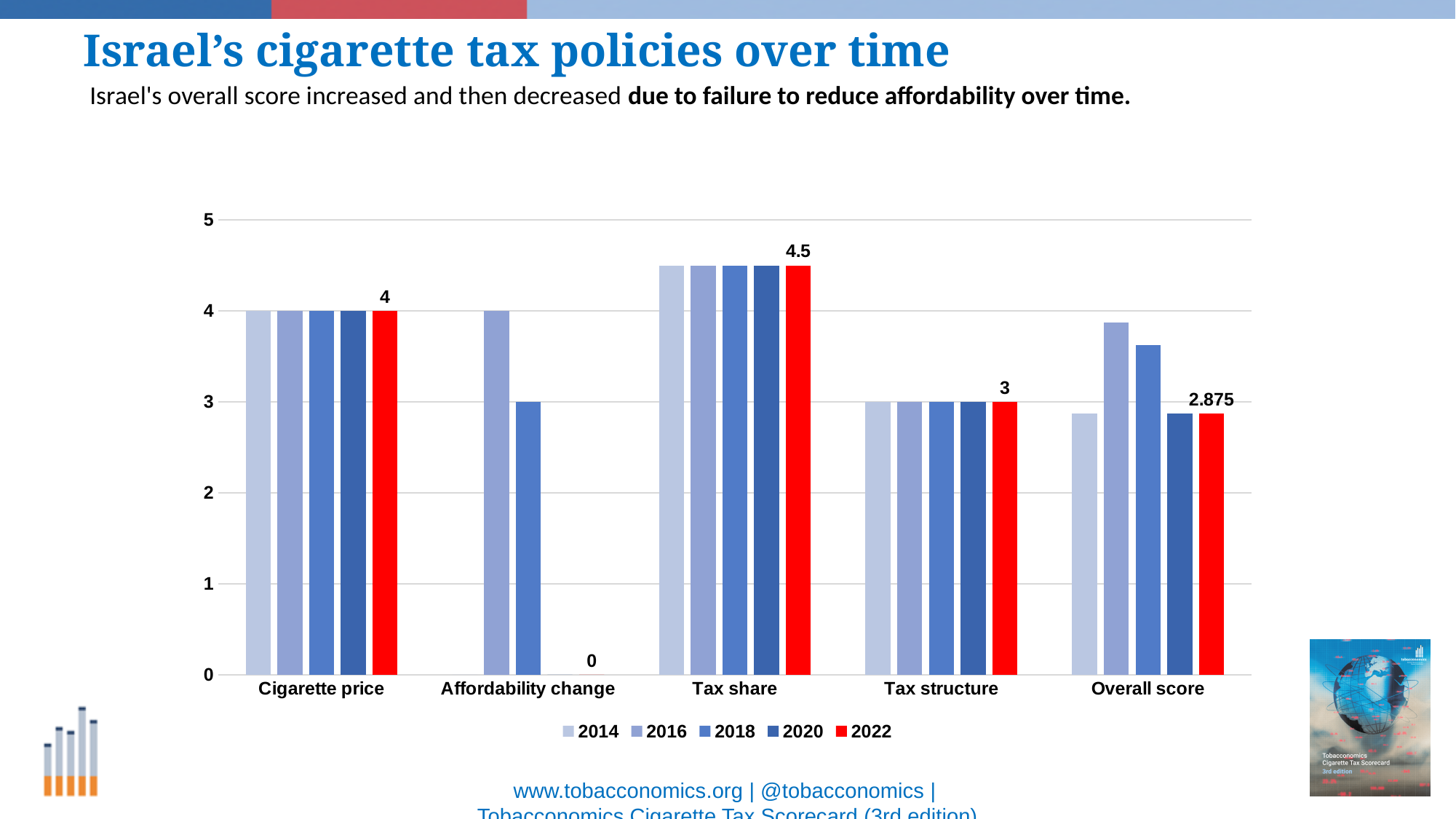
Among the 2022 bars, which category has the lowest value? Affordability change What is the difference between the 2022 values for Tax share and Tax structure? 1.5 Which is larger in 2022: Cigarette price or Overall score? Cigarette price What is the value for Affordability change in 2016? 4 What is the value for Tax share in 2022? 4.5 What is the value for Affordability change in 2022? 0 Among the 2022 bars, which category has the highest value? Tax share What is the Overall score for 2022? 2.875 What is the value for Cigarette price in 2022? 4 How many series does the legend list? 5 What kind of chart is shown on the slide? bar chart Is the Overall score for 2016 greater or less than 3? greater